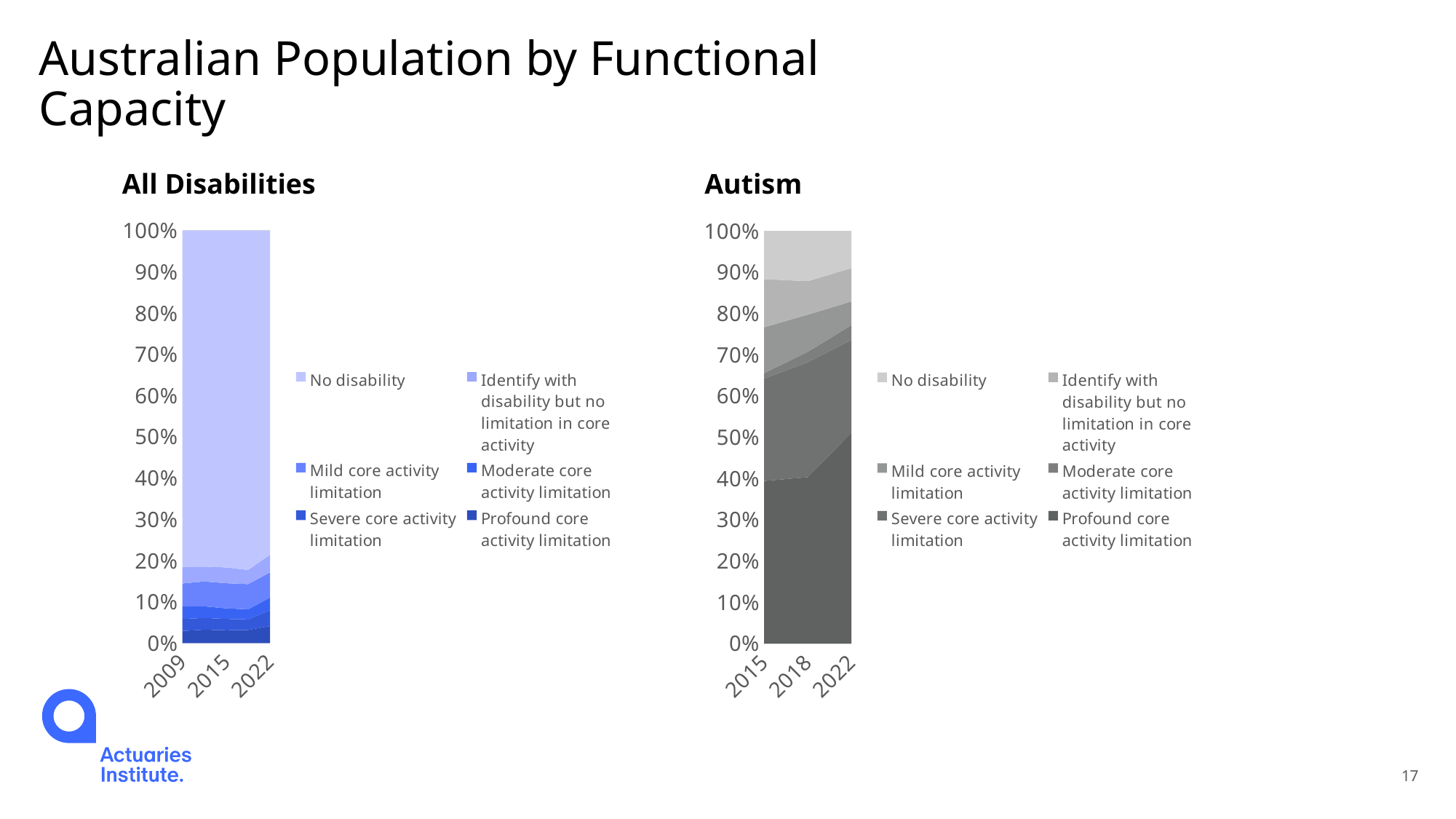
How many series does the legend of the Autism chart list? 6 Which years are on the x axis of the Autism chart? 2015, 2018, 2022 How many years are shown on the x axis of the All Disabilities chart? 3 How many series does the legend of the All Disabilities chart list? 6 What kind of chart is the Autism chart? stacked area chart In the All Disabilities chart, is the share of No disability in 2009 greater or less than 70%? greater What kind of chart is the All Disabilities chart? stacked area chart What is the title of the chart on the left of the slide? All Disabilities How many years are shown on the x axis of the Autism chart? 3 In the Autism chart, is the share of Profound core activity limitation in 2022 greater or less than 40%? greater In the Autism chart, does the share of Profound core activity limitation rise or fall from 2015 to 2022? rise In the Autism chart, is the share of No disability in 2015 greater or less than 20%? less